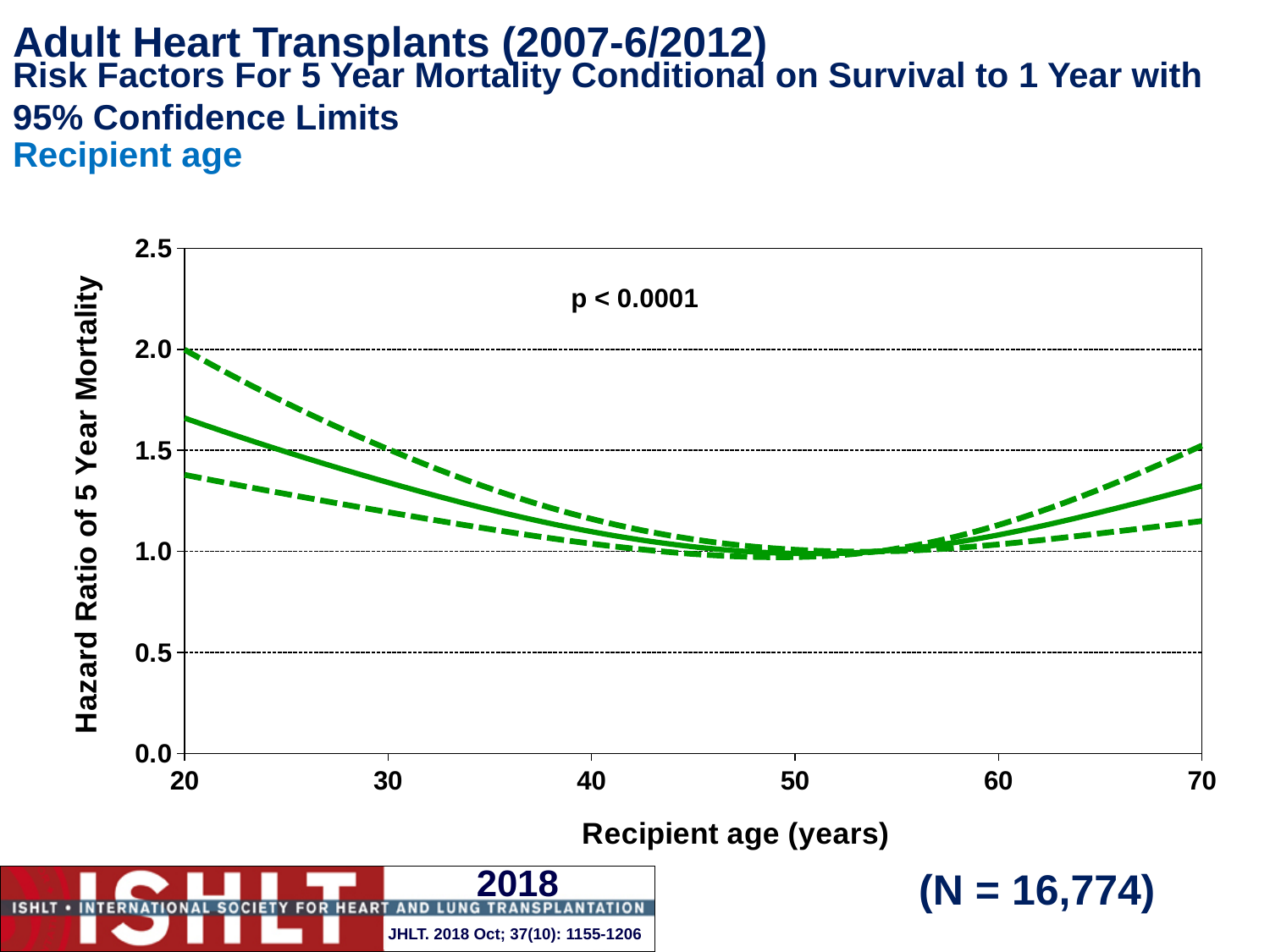
Is the upper dashed confidence limit at recipient age 70 greater or less than 1.0? greater Does the solid hazard ratio line rise or fall as recipient age increases from 50 to 70? rise Is the lower dashed confidence limit at recipient age 20 greater or less than 1.5? less Is the hazard ratio on the solid line at recipient age 70 greater or less than 1.5? less What p-value is printed on the chart? p < 0.0001 Is the hazard ratio on the solid line higher at recipient age 20 or at recipient age 70? 20 What sample size (N) is shown on the slide? N = 16,774 What kind of chart is shown on the slide? line chart Does the solid hazard ratio line rise or fall as recipient age increases from 20 to 50? fall How many lines are plotted on the chart? 3